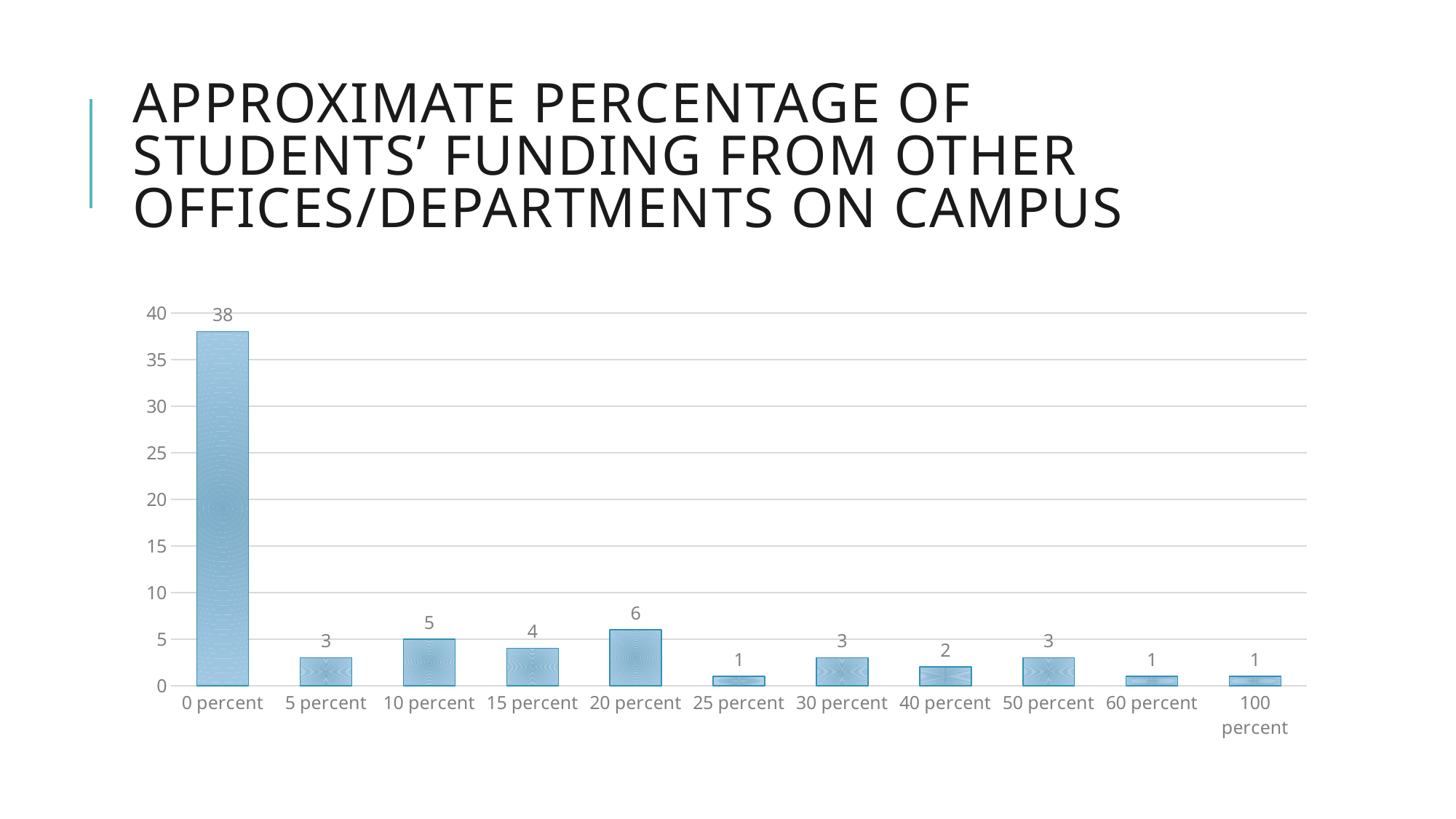
Is the value for 0 percent greater or less than 35? greater What kind of chart is shown on the slide? bar chart What is the value for the 20 percent category? 6 How many categories have a value of 1? 3 What is the value for the 0 percent category? 38 What is the difference between the values for 10 percent and 15 percent? 1 How many categories are shown on the x axis? 11 What is the title of the slide? Approximate percentage of students' funding from other offices/departments on campus What is the value for the 40 percent category? 2 Which is larger, the value for 10 percent or the value for 25 percent? 10 percent Which category has the highest value? 0 percent What is the difference between the values for 0 percent and 20 percent? 32